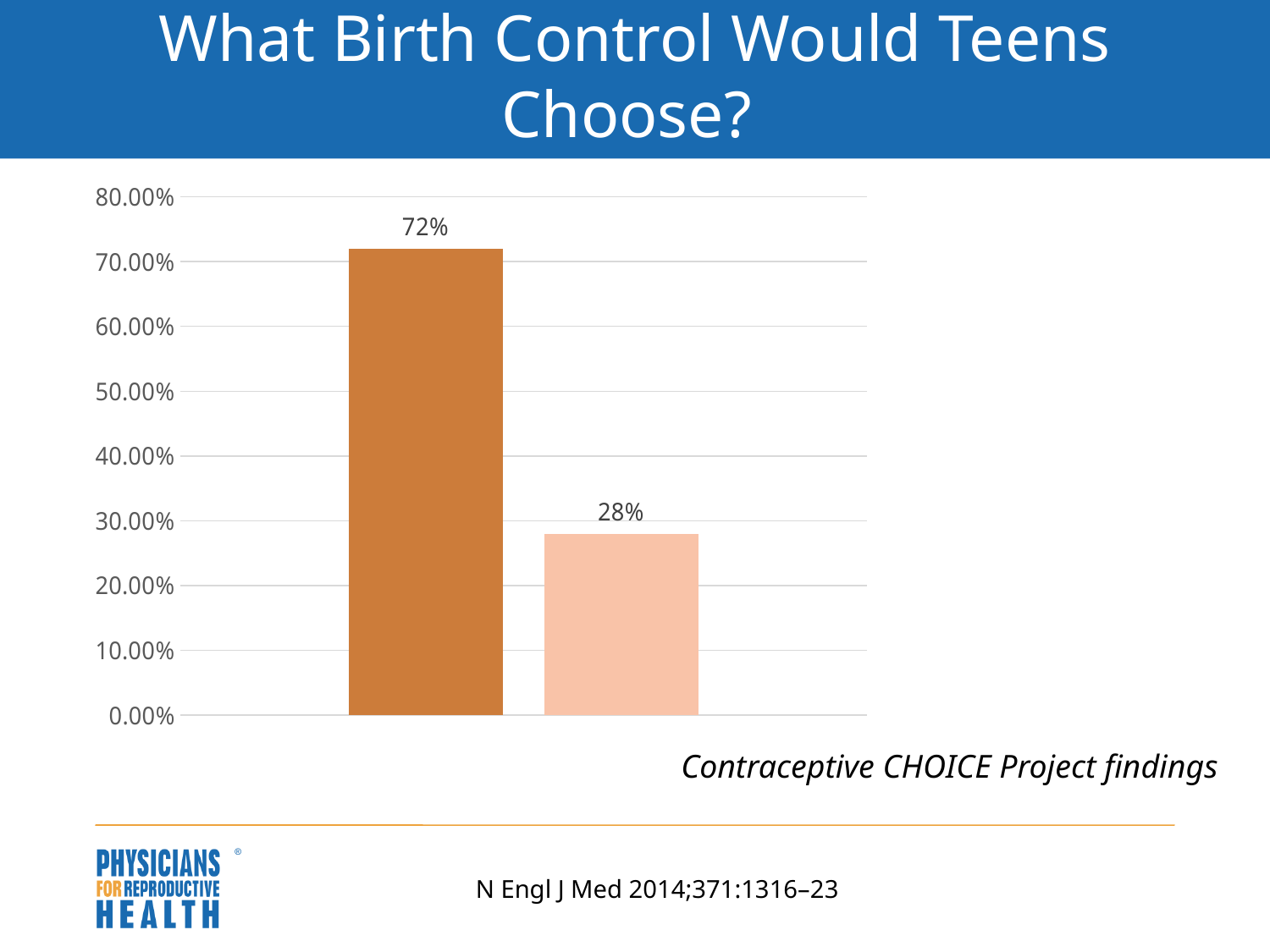
What kind of chart is shown on the slide? bar chart Is the value of the left bar greater or less than 70.00%? greater What is the difference between the left bar's value and the right bar's value? 44% Is the value of the left bar larger or smaller than the value of the right bar? larger Is the value of the right bar greater or less than 30.00%? less What value is shown on the left (darker orange) bar? 72% What value is shown on the right (lighter orange) bar? 28% What is the sum of the two bar values shown in the chart? 100% How many bars are plotted in the chart? 2 Which bar has the lowest value, the left bar or the right bar? the right bar What is the title of the slide containing the chart? What Birth Control Would Teens Choose? Which bar is taller, the left bar or the right bar? the left bar